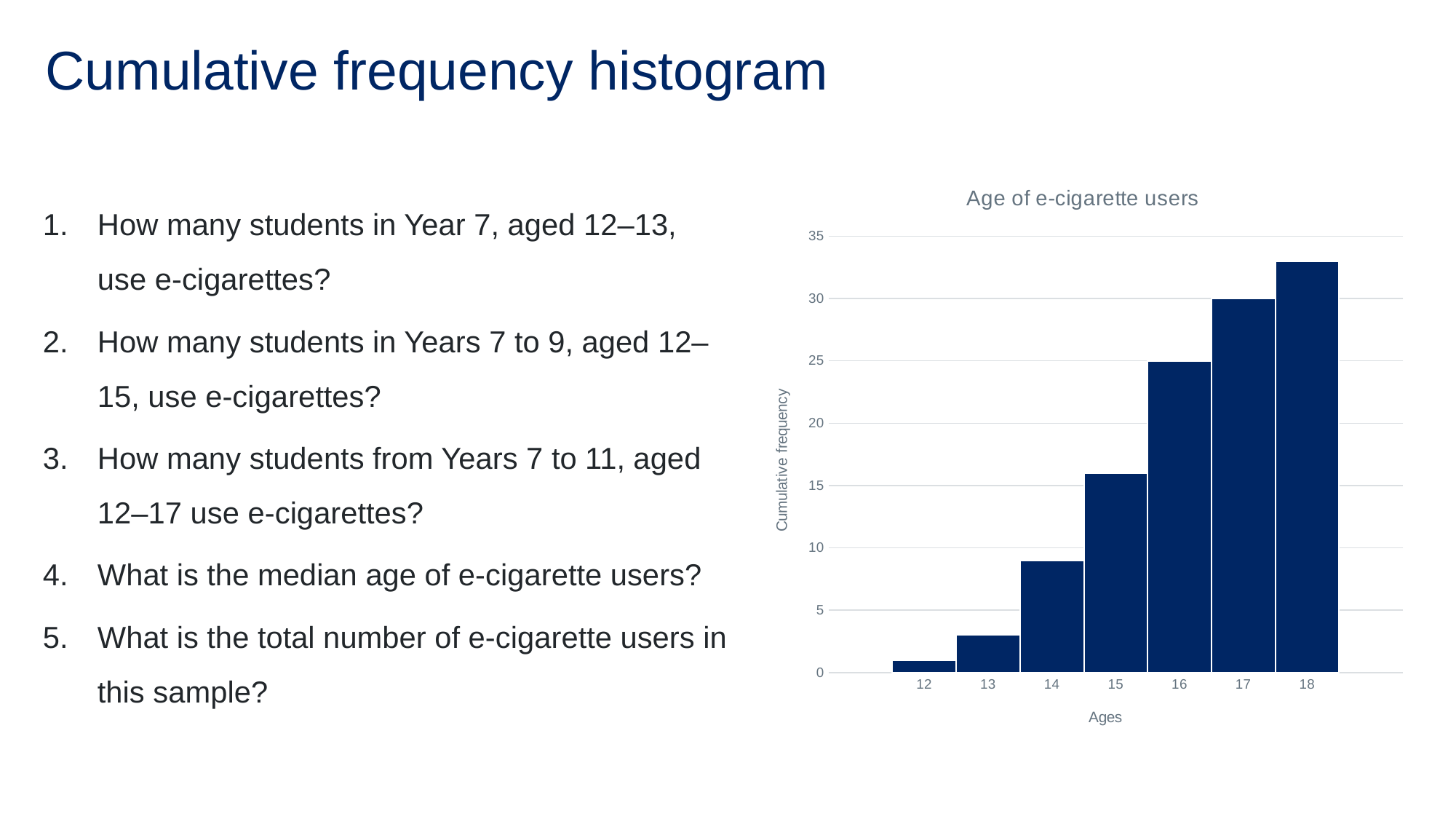
What is the cumulative frequency for age 17? 30 What kind of chart is shown on the slide? bar chart How many age categories are plotted on the x axis? 7 What is the label of the vertical axis of the chart? Cumulative frequency Which age has the lowest cumulative frequency? 12 Which age has the highest cumulative frequency? 18 What is the title of the chart? Age of e-cigarette users Do the cumulative frequency values rise or fall as age increases along the x axis? rise Is the cumulative frequency for age 14 greater or less than 10? less Is the cumulative frequency for age 15 greater or less than 15? greater What is the cumulative frequency for age 16? 25 Is the cumulative frequency for age 18 greater or less than 30? greater